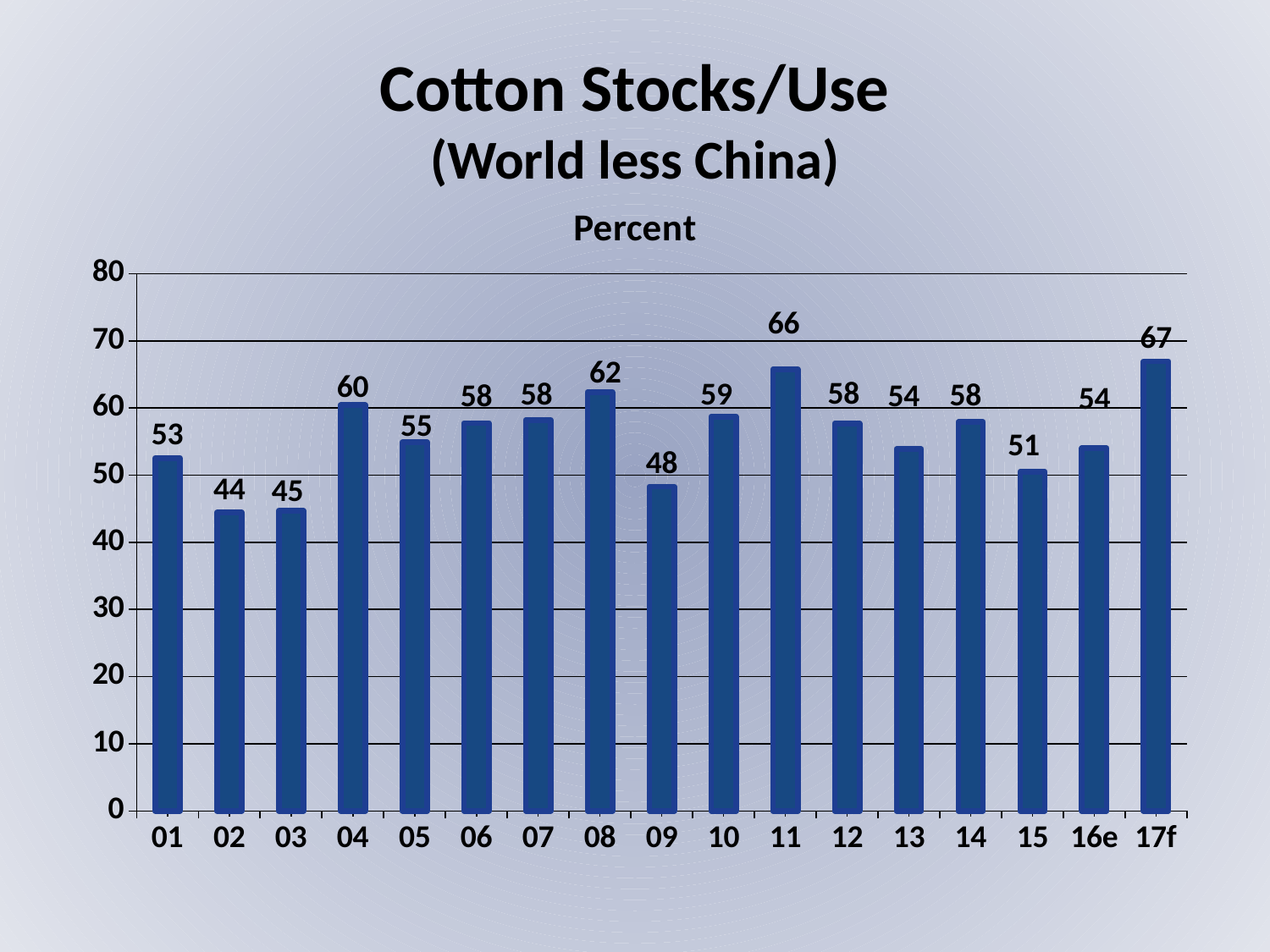
Is the value for 15 greater or less than 60? less What is the value for 09? 48 How many bars are shown in the chart? 17 Do the values rise or fall from 01 to 02? fall Which year has the highest value? 17f What is the title of the chart? Cotton Stocks/Use (World less China) Which is larger, the value for 08 or the value for 12? 08 What is the difference between the values for 11 and 09? 18 Which year has the lowest value? 02 What is the value for 04? 60 What is the value for 17f? 67 What kind of chart is shown? bar chart